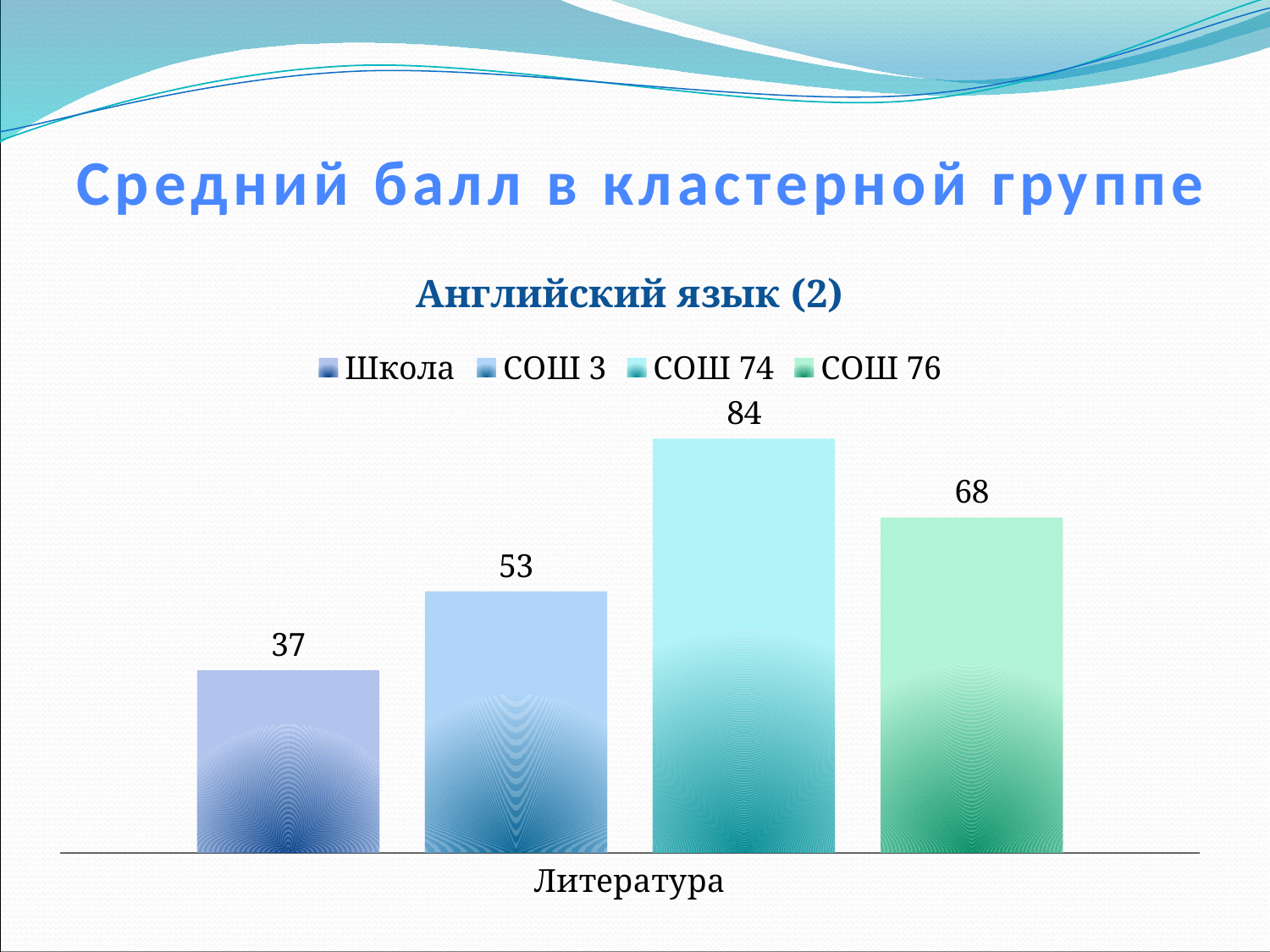
Which series has the lowest value? Школа What kind of chart is shown? Bar chart Which is larger, the value for СОШ 3 or the value for СОШ 76? СОШ 76 What is the difference between the values for СОШ 74 and Школа? 47 What is the difference between the values for СОШ 76 and СОШ 3? 15 What is the value for Школа? 37 Which series has the highest value? СОШ 74 How many series does the legend list? 4 What is the title of the chart? Английский язык (2) What is the value for СОШ 3? 53 What is the value for СОШ 76? 68 What is the value for СОШ 74? 84